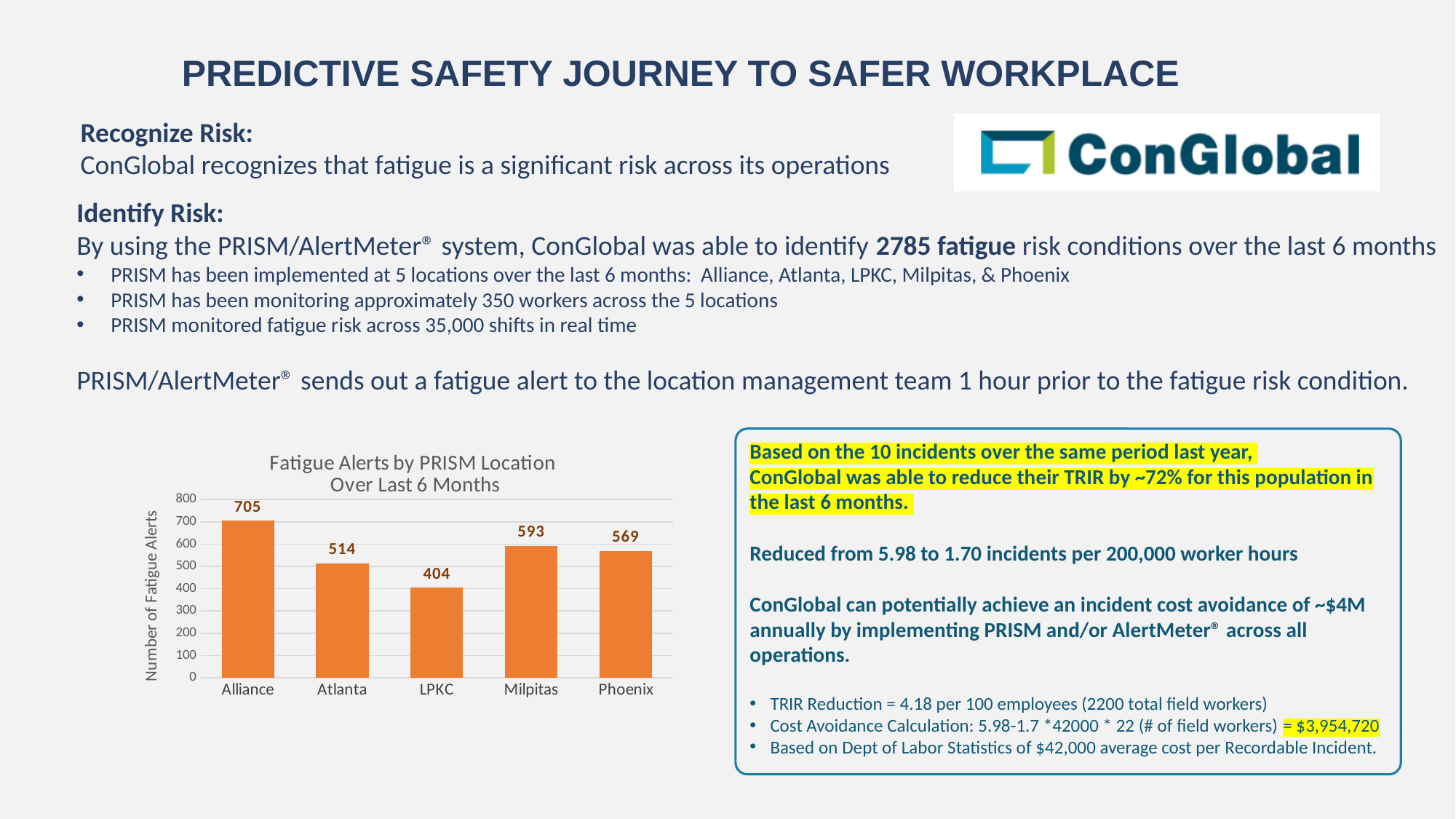
What is the number of fatigue alerts for Alliance? 705 Is the value for Atlanta greater or less than 500? greater Which location has the highest number of fatigue alerts? Alliance Which location has more fatigue alerts, Milpitas or Phoenix? Milpitas How many locations are shown in the chart? 5 Which location has the lowest number of fatigue alerts? LPKC What is the number of fatigue alerts for Milpitas? 593 What is the difference in fatigue alerts between Alliance and Atlanta? 191 What kind of chart is shown on the slide? bar chart What is the number of fatigue alerts for LPKC? 404 What is the title of the chart? Fatigue Alerts by PRISM Location Over Last 6 Months What is the label of the vertical axis of the chart? Number of Fatigue Alerts